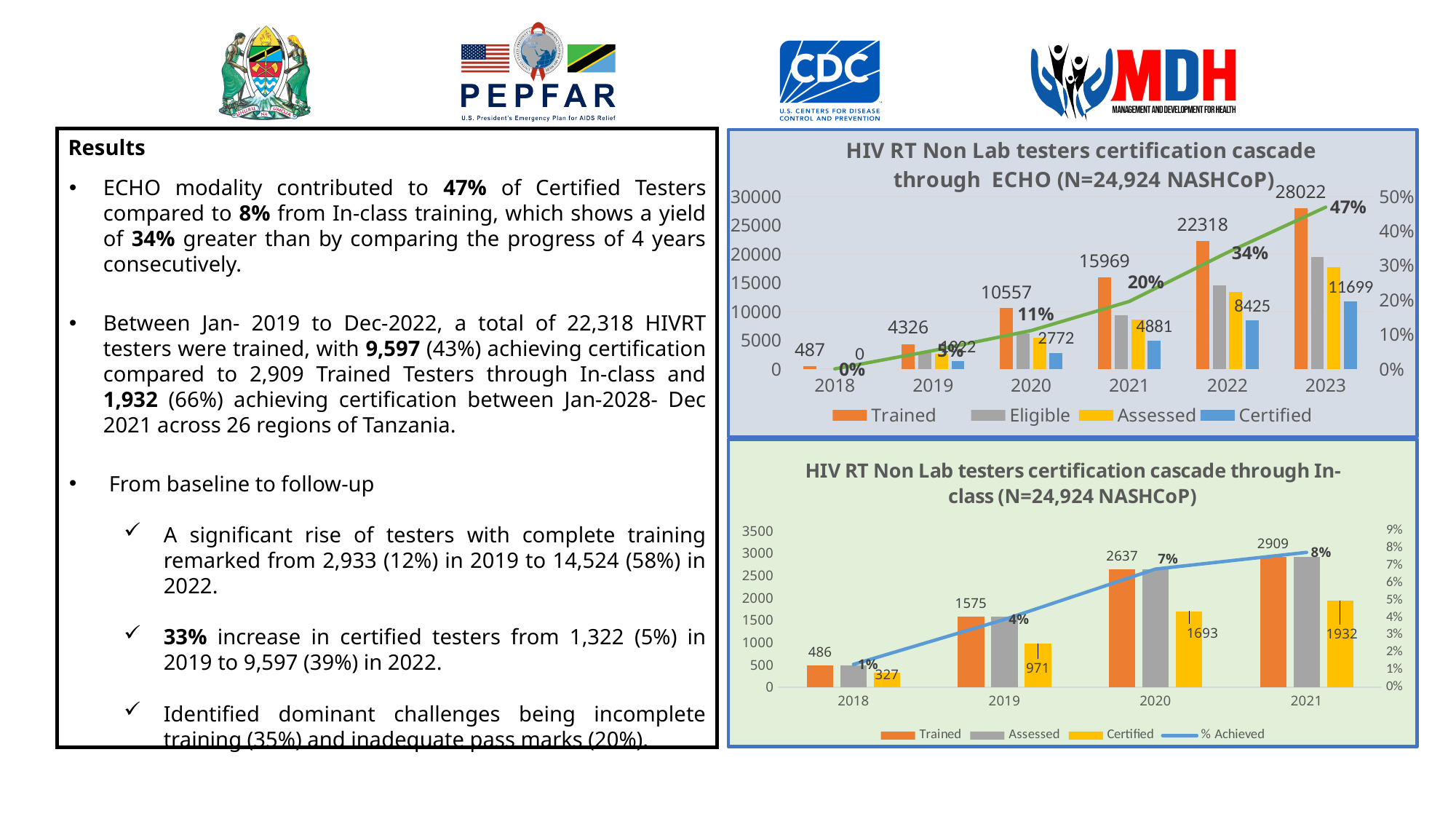
In the top chart (ECHO cascade), which year has the highest Trained value? 2023 In the top chart (ECHO cascade), how many years are shown on the x axis? 6 In the bottom chart (In-class cascade), how many entries does the legend list? 4 In the top chart (ECHO cascade), do the Trained values rise or fall from 2018 to 2023? rise In the top chart (ECHO cascade), what is the difference between the Trained values for 2022 and 2021? 6349 In the bottom chart (In-class cascade), which is larger in 2020: the Trained value or the Certified value? Trained In the top chart (ECHO cascade), what is the Trained value for 2023? 28022 In the bottom chart (In-class cascade), what is the difference between the Certified values for 2021 and 2020? 239 In the bottom chart (In-class cascade), what is the Trained value for 2021? 2909 In the top chart (ECHO cascade), what percentage is shown on the line for 2023? 47% In the top chart (ECHO cascade), what is the Certified value for 2022? 8425 In the bottom chart (In-class cascade), what is the Certified value for 2019? 971